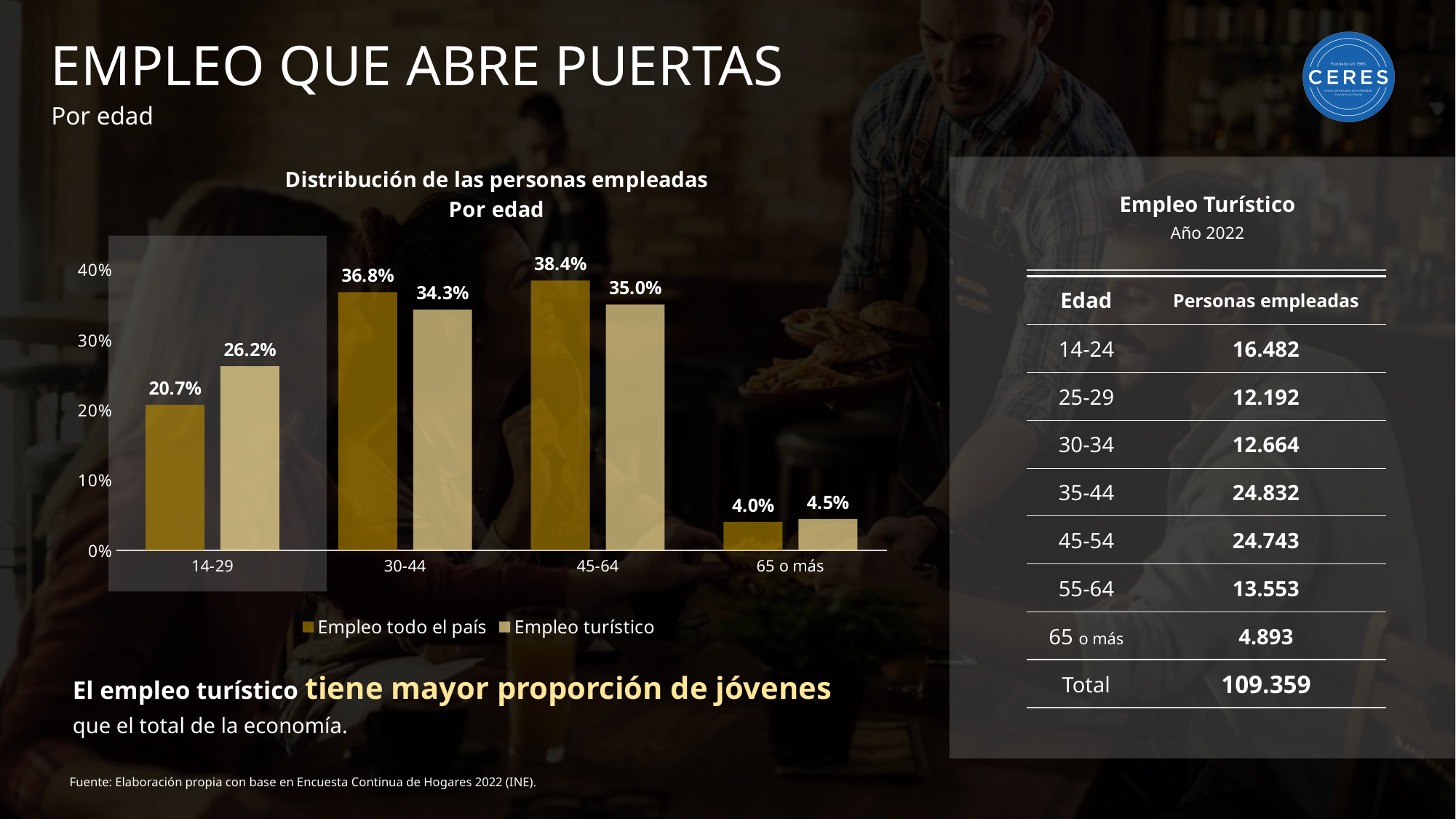
What type of chart is shown on the slide? Bar chart What is the difference between Empleo turístico and Empleo todo el país in the 14-29 age group? 5.5 percentage points How many age categories are shown on the x axis of the chart? 4 What is the title of the chart? Distribución de las personas empleadas Por edad Which age group has the highest value for Empleo todo el país? 45-64 How many series does the chart legend list? 2 What is the value for Empleo turístico in the 65 o más age group? 4.5% Is the value for Empleo todo el país in the 30-44 age group greater or less than 30%? greater What is the value for Empleo todo el país in the 45-64 age group? 38.4% In the 45-64 age group, which is larger: Empleo todo el país or Empleo turístico? Empleo todo el país Which age group has the lowest value for Empleo turístico? 65 o más What is the value for Empleo turístico in the 14-29 age group? 26.2%